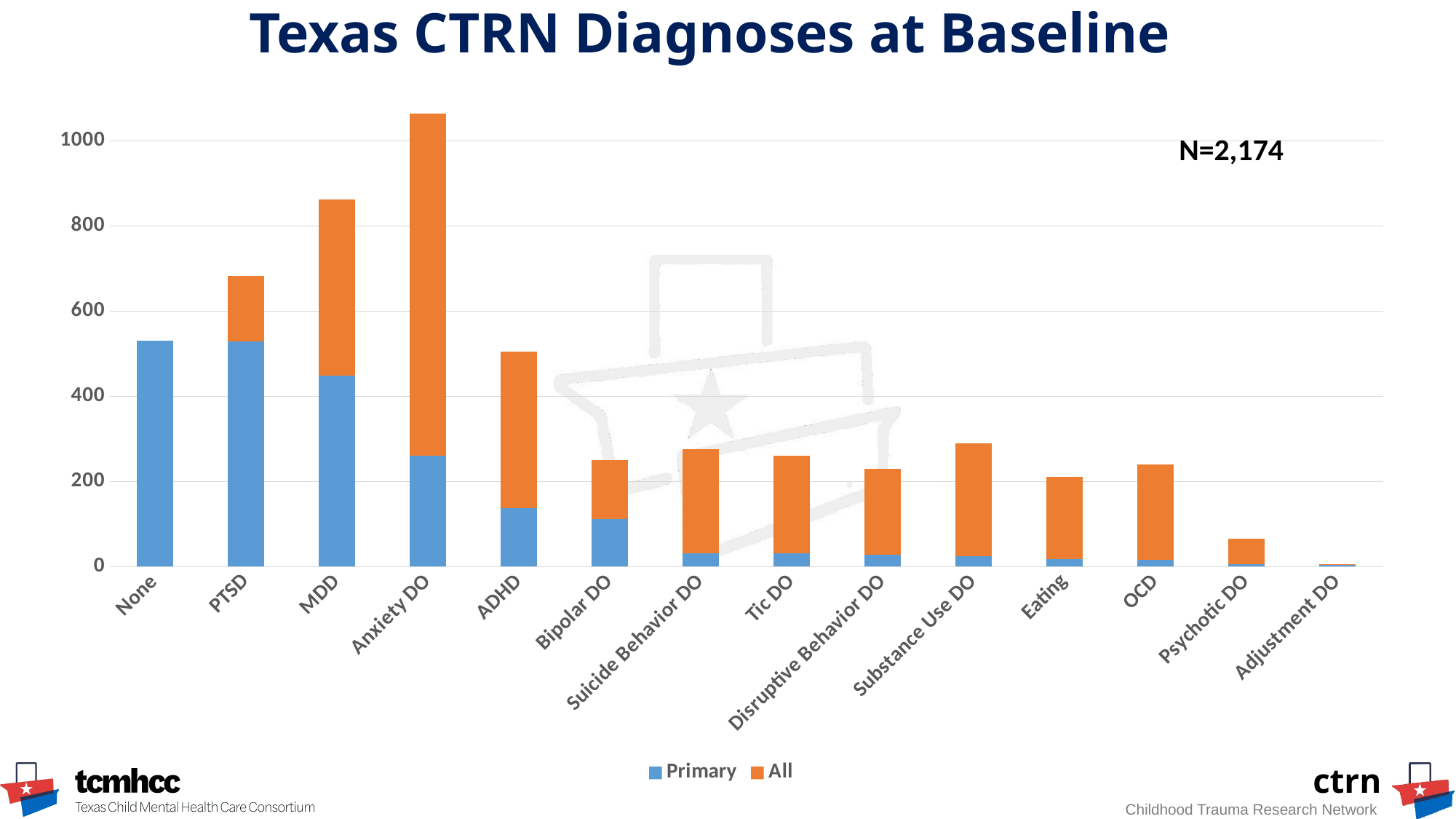
What kind of chart is shown on the slide? Stacked bar chart How many diagnosis categories are shown on the x axis? 14 Is the total bar height for Psychotic DO greater or less than 200? less Which has a taller total bar, Substance Use DO or Eating? Substance Use DO Is the total bar height for MDD greater or less than 800? greater Which diagnosis category has the shortest bar overall? Adjustment DO Is the total bar height for PTSD greater or less than 800? less How many series does the legend list? 2 Which diagnosis category has the tallest bar overall? Anxiety DO What sample size (N) is printed on the chart? N=2,174 Which has a taller total bar, MDD or PTSD? MDD